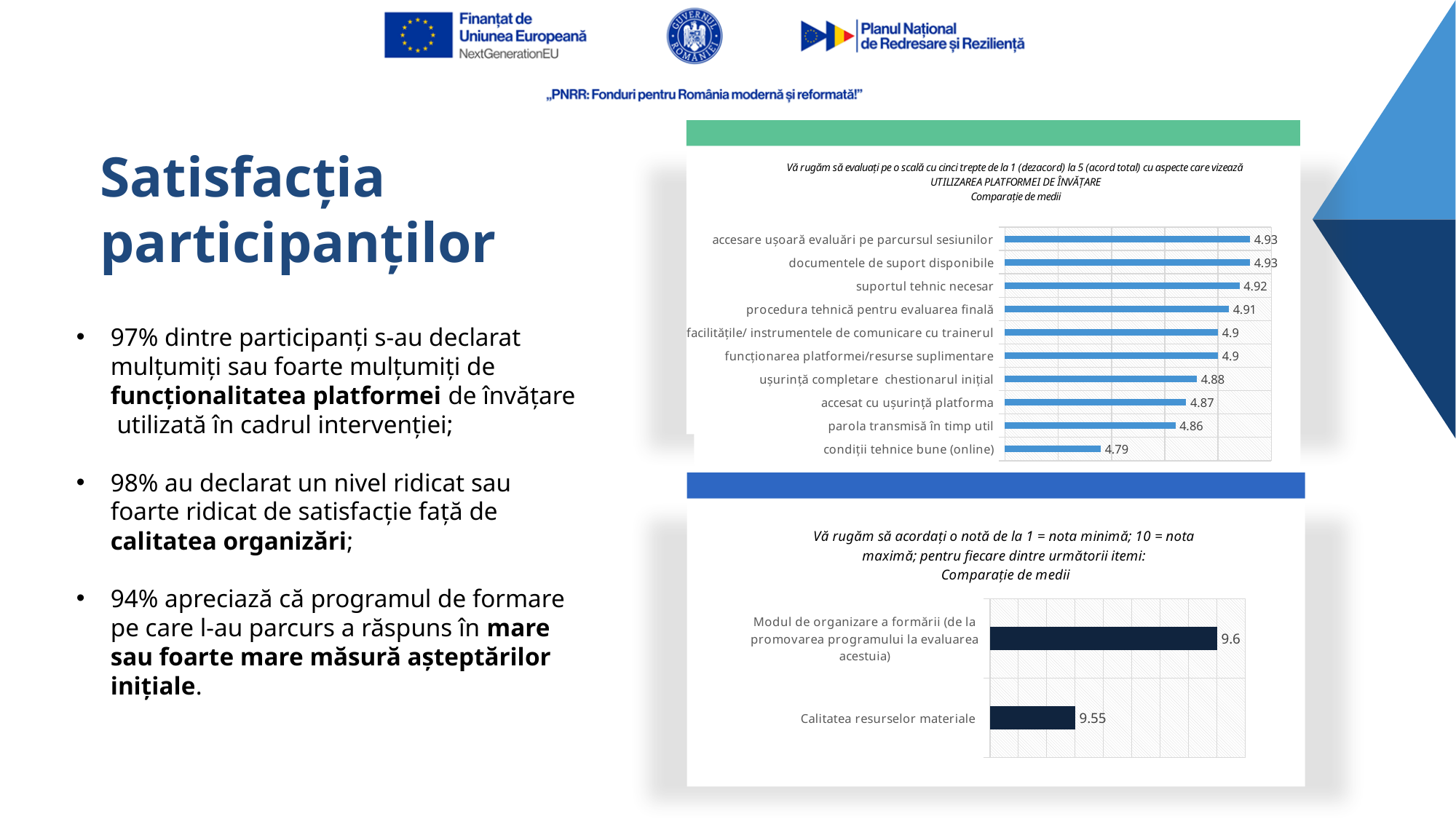
In the top chart, which category has the lowest value? condiții tehnice bune (online) In the top chart, what is the value for "condiții tehnice bune (online)"? 4.79 In the top chart, what is the value for "parola transmisă în timp util"? 4.86 In the bottom chart, what is the value for "Modul de organizare a formării (de la promovarea programului la evaluarea acestuia)"? 9.6 In the bottom chart, what is the difference between the two plotted values? 0.05 In the bottom chart, which category has the highest value? Modul de organizare a formării (de la promovarea programului la evaluarea acestuia) In the top chart, which is larger: the value for "ușurință completare chestionarul inițial" or the value for "accesat cu ușurință platforma"? ușurință completare chestionarul inițial In the top chart, what is the difference between the values for "accesare ușoară evaluări pe parcursul sesiunilor" and "condiții tehnice bune (online)"? 0.14 What kind of chart is the top chart? bar chart In the top chart, how many categories are plotted? 10 In the top chart, what is the value for "suportul tehnic necesar"? 4.92 In the bottom chart, what is the value for "Calitatea resurselor materiale"? 9.55